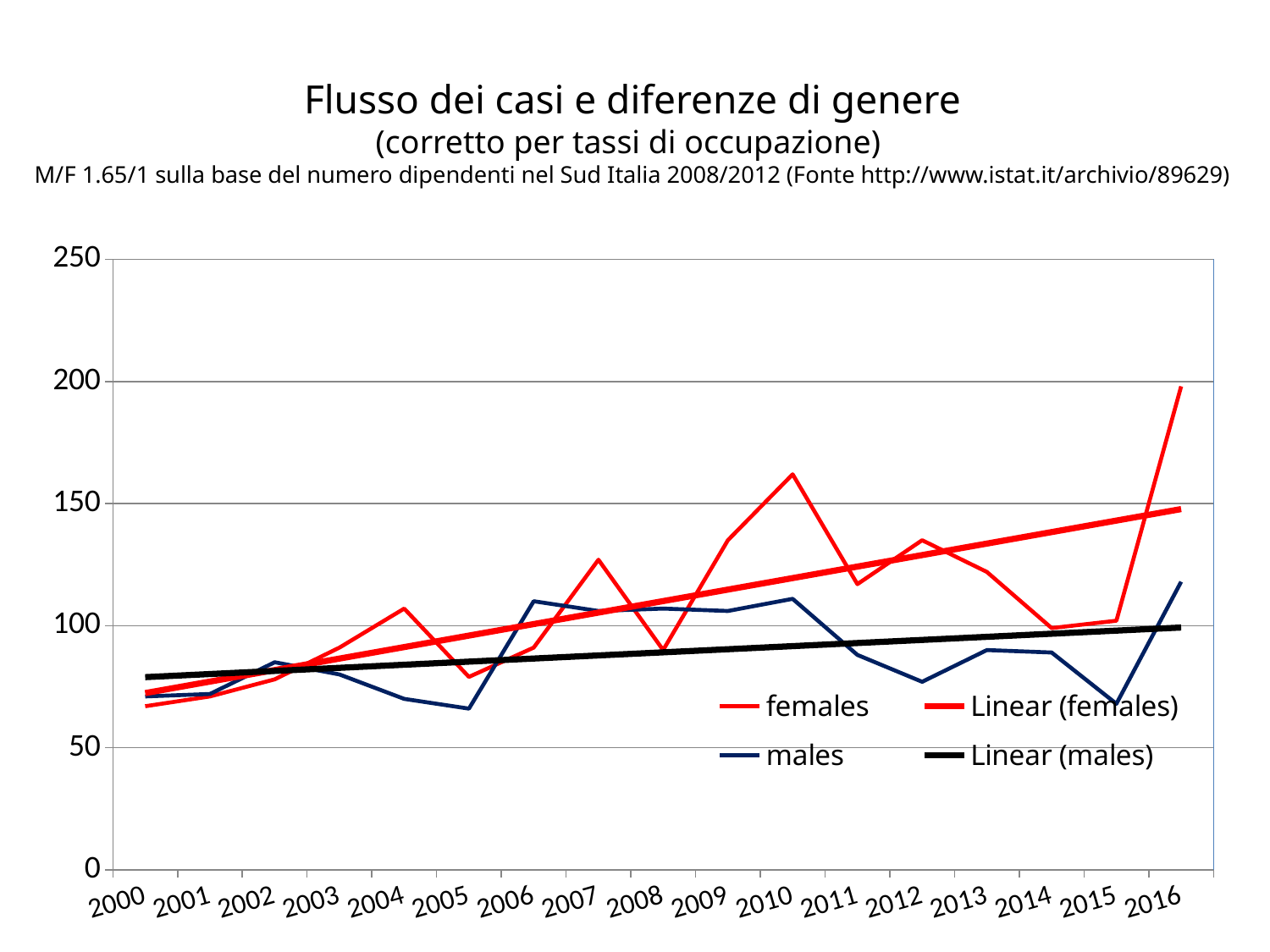
How many entries does the legend list? 4 In which year does the females series reach its highest value? 2016 What kind of chart is shown on the slide? line chart Is the value for females in 2016 greater or less than 150? greater In 2006, which series has the larger value, females or males? males Is the value for females in 2010 greater or less than 150? greater In 2016, which series has the larger value, females or males? females Is the value for males in 2005 greater or less than 100? less How many years are shown along the x axis? 17 Does the Linear (females) trendline rise or fall from 2000 to 2016? rise What is the main title of the chart? Flusso dei casi e diferenze di genere